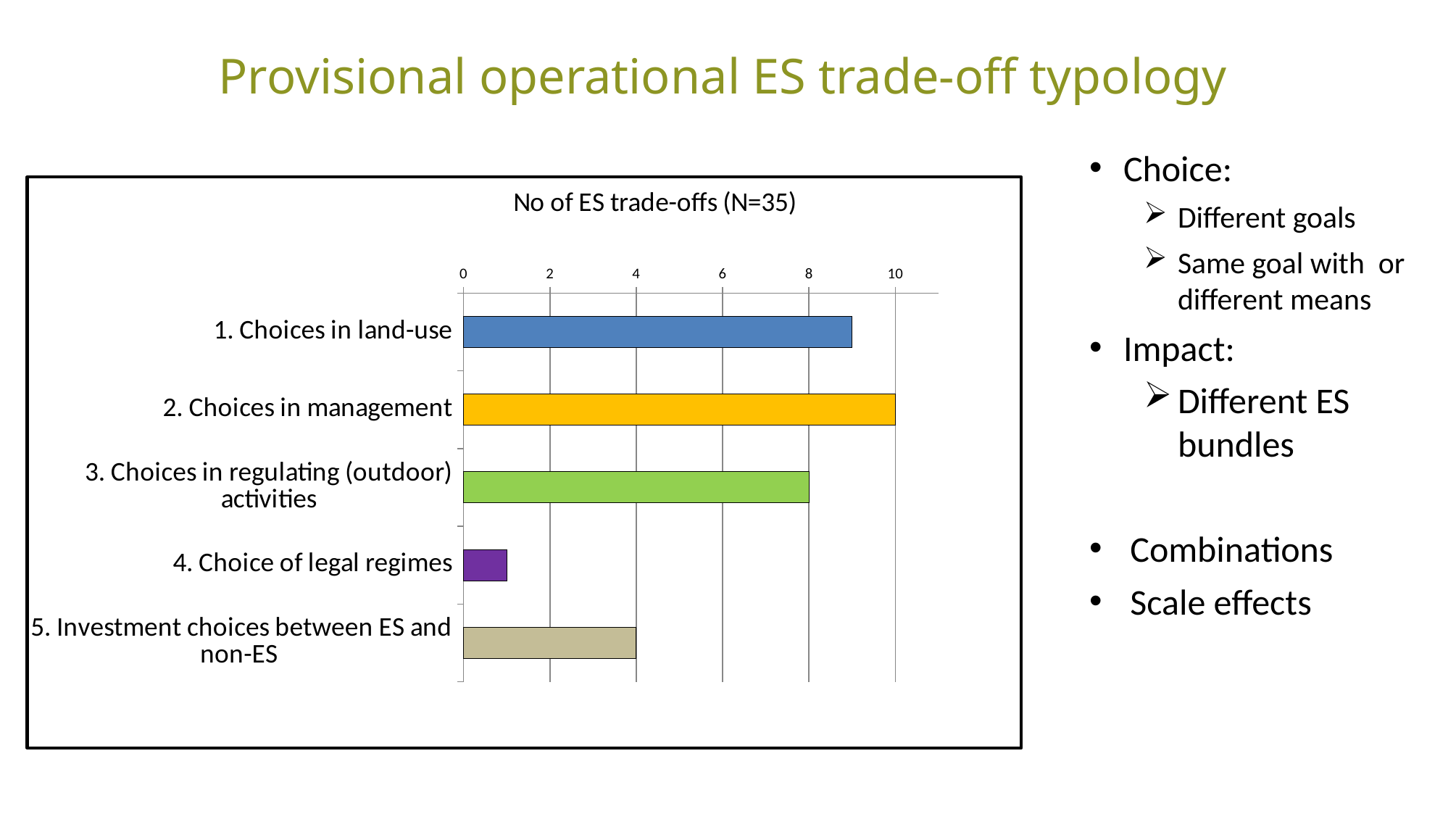
Is the value for "1. Choices in land-use" greater or less than 8? greater What is the value for "3. Choices in regulating (outdoor) activities"? 8 What is the difference between the values for "2. Choices in management" and "3. Choices in regulating (outdoor) activities"? 2 How many categories are plotted in the chart? 5 Which is larger, the value for "1. Choices in land-use" or for "5. Investment choices between ES and non-ES"? 1. Choices in land-use Which category has the lowest value? 4. Choice of legal regimes Which category has the highest value? 2. Choices in management What is the title of the chart? No of ES trade-offs (N=35) Is the value for "4. Choice of legal regimes" greater or less than 2? less What is the value for "2. Choices in management"? 10 What kind of chart is shown on the slide? bar chart What is the value for "5. Investment choices between ES and non-ES"? 4